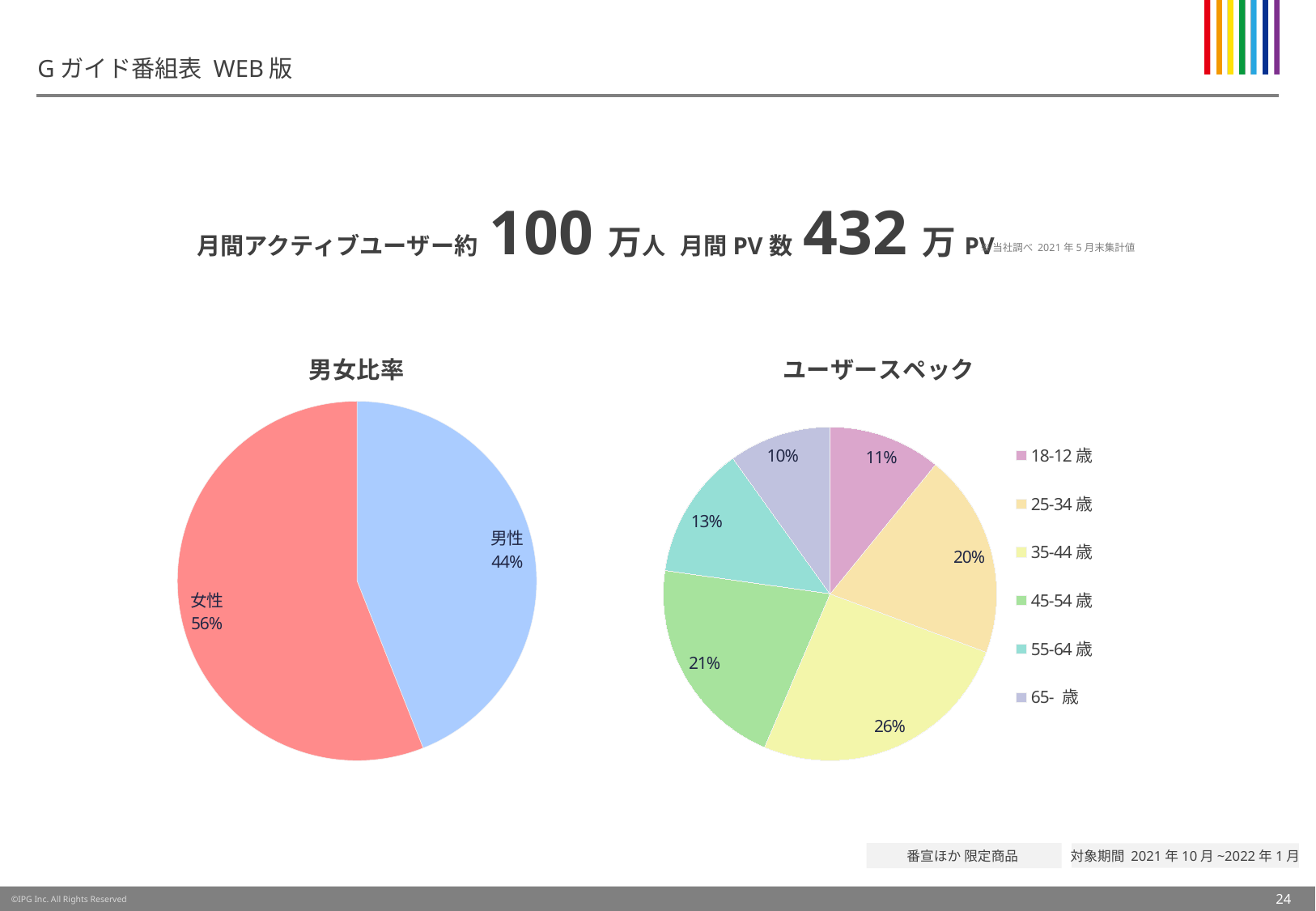
What kind of chart is the 男女比率 chart? pie chart In the ユーザースペック chart, what share is 55-64 歳? 13% In the ユーザースペック chart, which age group has the smallest share? 65- 歳 In the ユーザースペック chart, how many age groups does the legend list? 6 In the 男女比率 chart, which is larger, 女性 or 男性? 女性 In the ユーザースペック chart, which is larger, 18-12 歳 or 65- 歳? 18-12 歳 In the ユーザースペック chart, which age group has the largest share? 35-44 歳 In the ユーザースペック chart, what is the difference between the 45-54 歳 and 25-34 歳 shares? 1% In the 男女比率 chart, what share is 女性? 56% In the 男女比率 chart, what share is 男性? 44% In the 男女比率 chart, what is the difference between the 女性 and 男性 shares? 12% In the ユーザースペック chart, what share is 35-44 歳? 26%